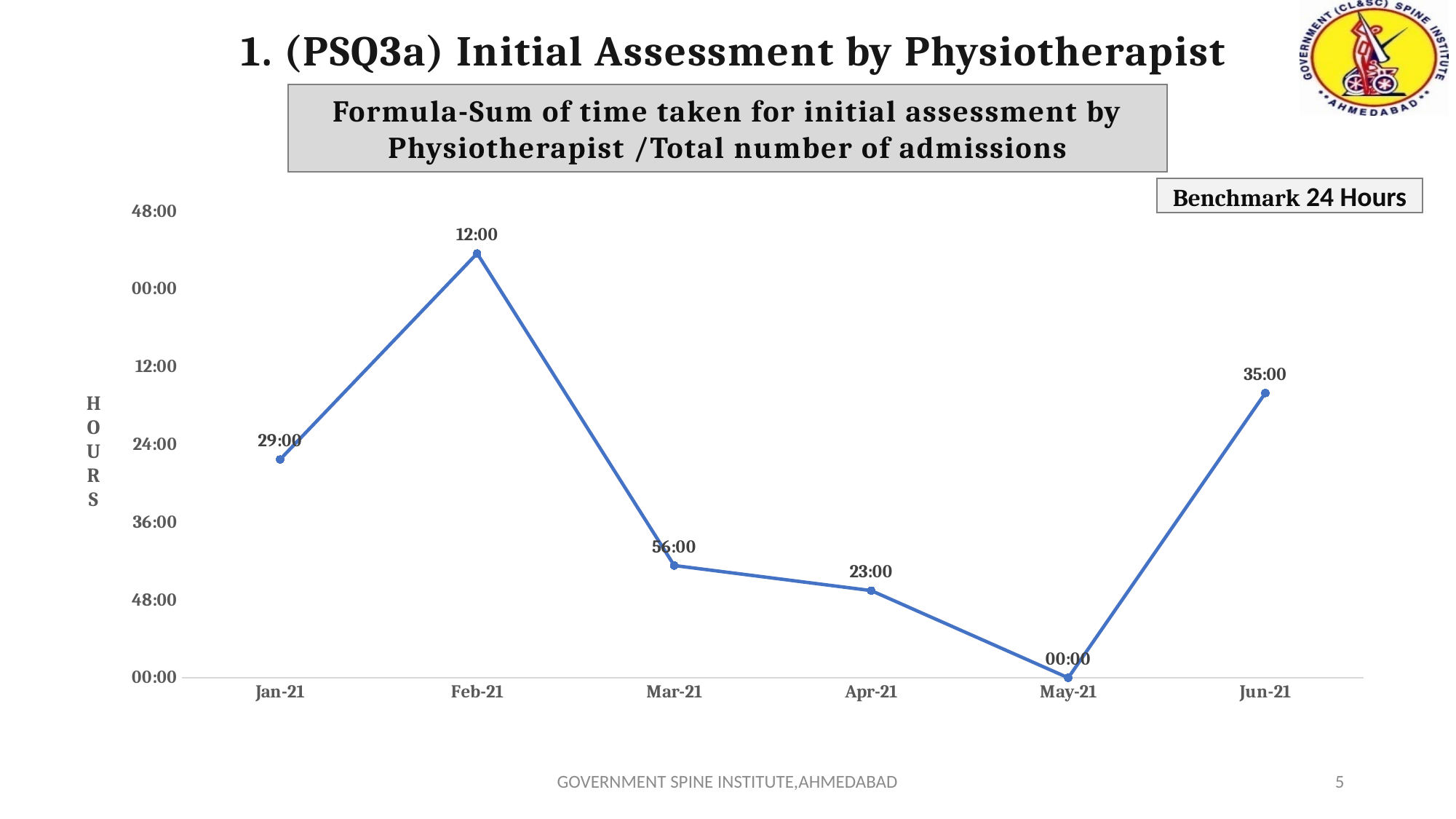
How many months are plotted on the x axis? 6 What benchmark is stated on the slide? 24 Hours Which month has the highest plotted point on the line? Feb-21 Does the line rise or fall from Mar-21 to May-21? Fall What is the data label for Jan-21? 29:00 What kind of chart is shown on the slide? Line chart Which month has the lowest plotted point on the line? May-21 What is the data label for Feb-21? 12:00 What is the data label for Mar-21? 56:00 What is the data label for Apr-21? 23:00 What is the data label for Jun-21? 35:00 What is the data label for May-21? 00:00